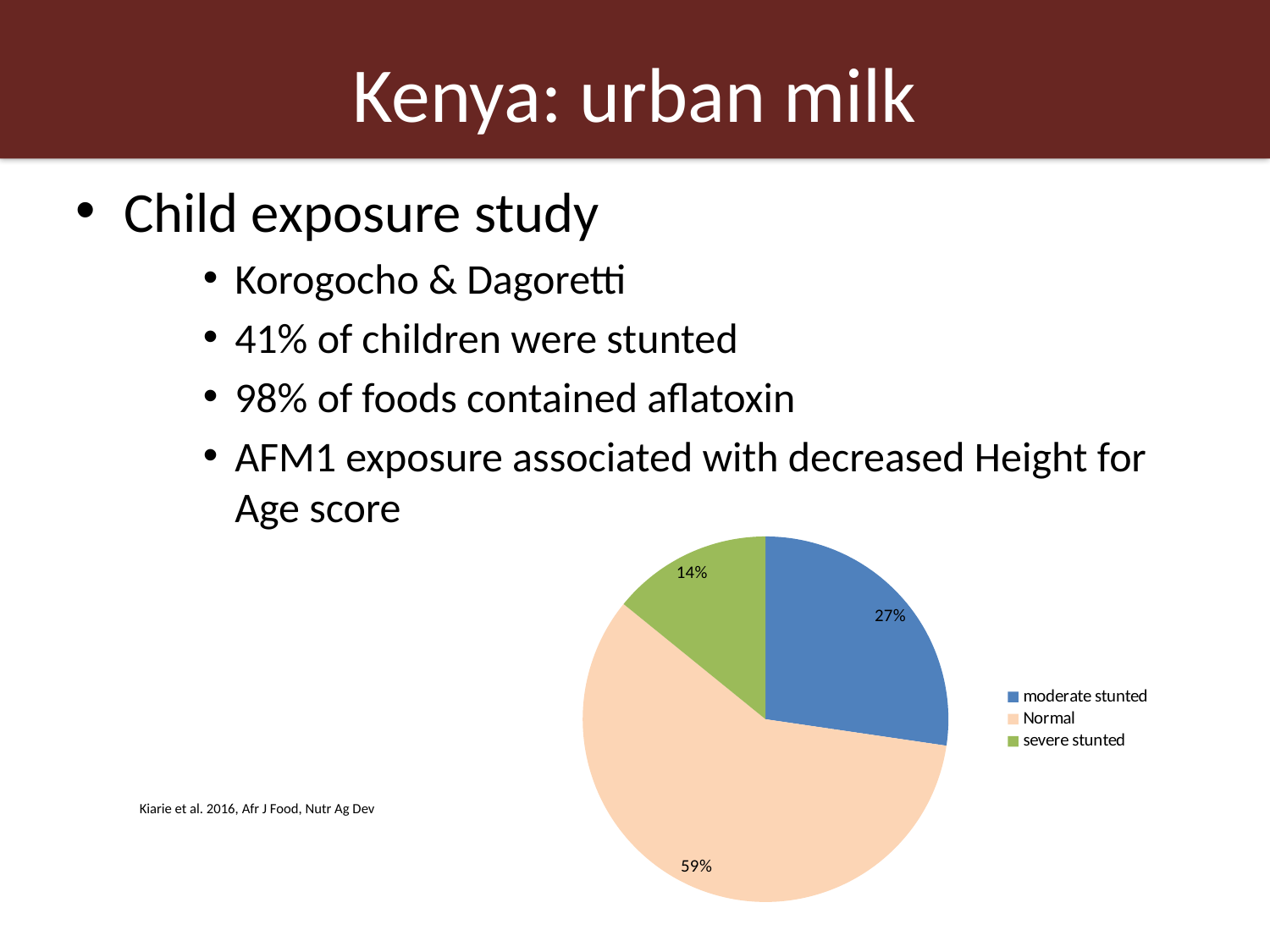
Which legend entry is shown in green? severe stunted What percentage of the pie chart is labelled Normal? 59% How many categories does the pie chart show? 3 What is the difference in percentage points between the Normal slice and the moderate stunted slice? 32 What is the combined percentage of the moderate stunted and severe stunted slices? 41% Which slice is larger, moderate stunted or severe stunted? moderate stunted What percentage of the pie chart is labelled severe stunted? 14% What colour is the Normal slice in the pie chart? peach What percentage of the pie chart is labelled moderate stunted? 27% What kind of chart is shown on the slide? pie chart Which category has the largest slice of the pie chart? Normal Which category has the smallest slice of the pie chart? severe stunted